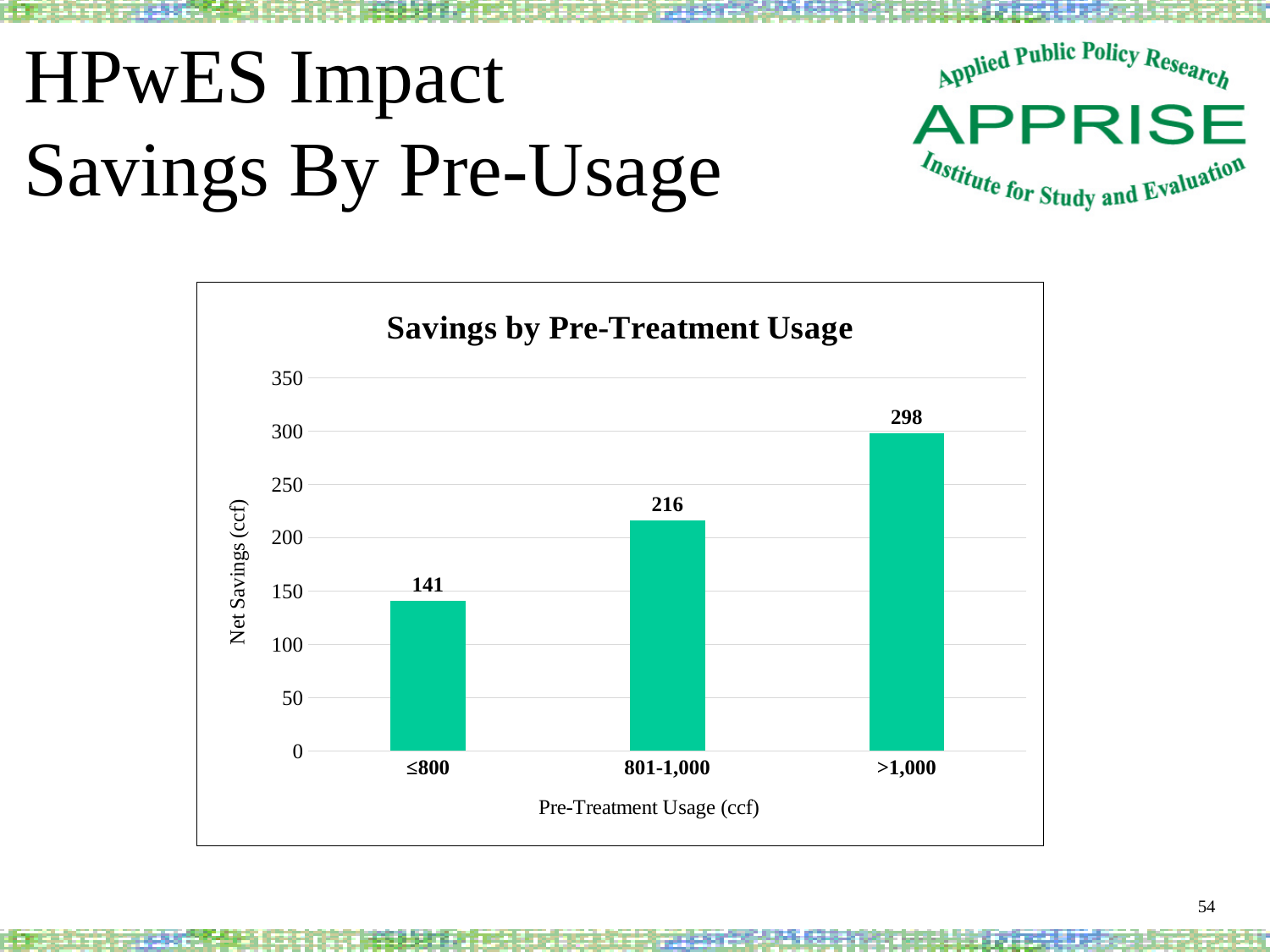
What is the net savings value for the 801-1,000 pre-treatment usage group? 216 What is the difference in net savings between the 801-1,000 group and the ≤800 group? 75 Is the net savings value for the 801-1,000 group greater or less than 200? greater Which pre-treatment usage group has the highest net savings? >1,000 What is the difference in net savings between the >1,000 group and the ≤800 group? 157 Which pre-treatment usage group has the lowest net savings? ≤800 What kind of chart is shown on the slide? Bar chart What is the net savings value for the >1,000 pre-treatment usage group? 298 Do net savings rise or fall as pre-treatment usage increases along the x axis? Rise What is the net savings value for the ≤800 pre-treatment usage group? 141 How many pre-treatment usage categories are shown in the chart? 3 Which group has larger net savings, 801-1,000 or >1,000? >1,000